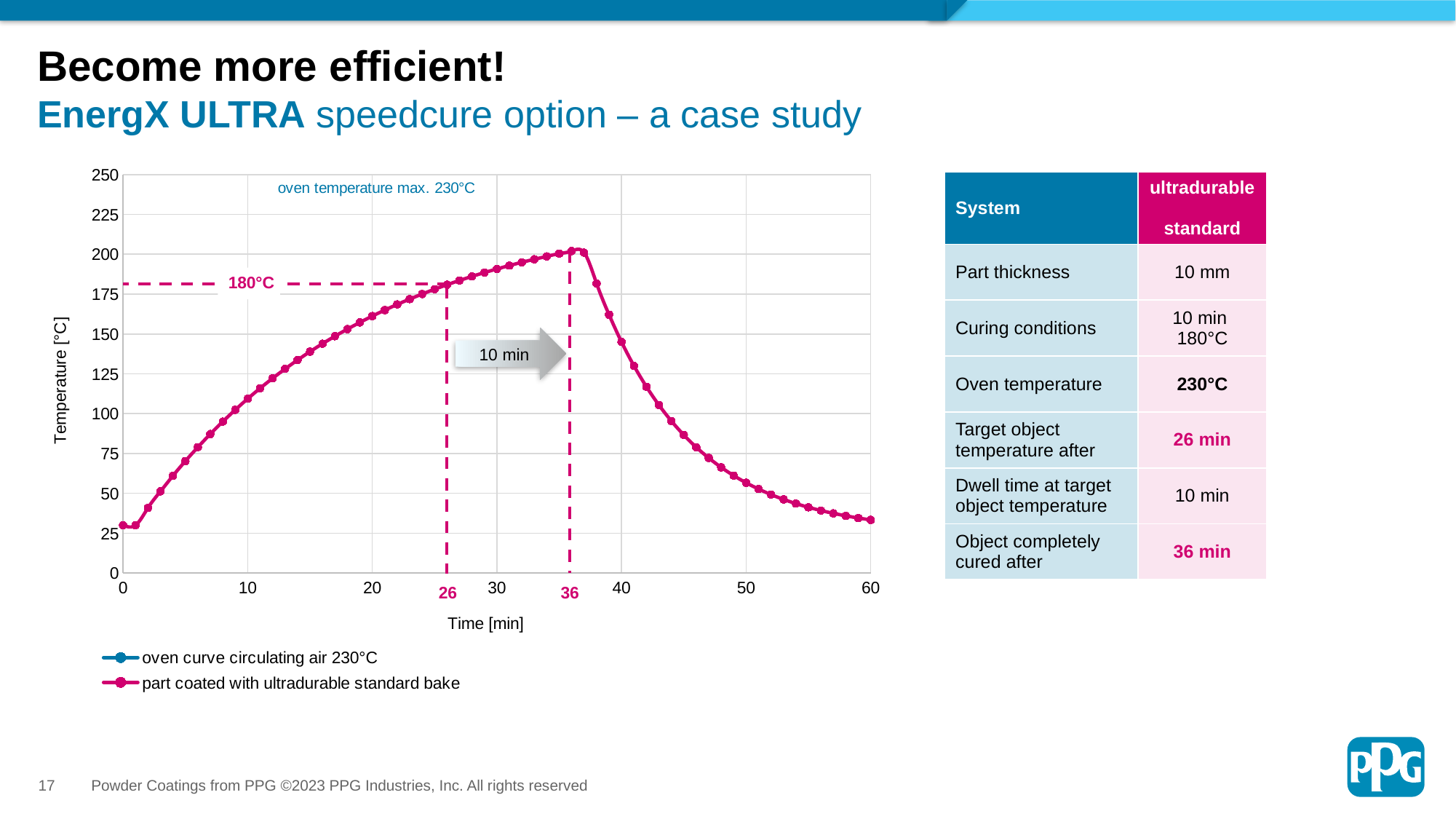
Is the temperature of the part at 50 min greater or less than 75? less What temperature does the horizontal dashed line on the chart mark? 180°C Does the part temperature rise or fall between 40 and 60 min? fall Does the part temperature rise or fall between 0 and 26 min? rise Is the temperature of the part at 20 min greater or less than 125? greater What is the title of the y axis of the chart? Temperature [°C] What kind of chart is shown on the slide? line chart What is the title of the x axis of the chart? Time [min] How many series does the chart legend list? 2 Is the temperature of the part at 10 min greater or less than 100? greater At what time does the part coated with ultradurable standard bake reach 180°C, according to the dashed marker on the chart? 26 min